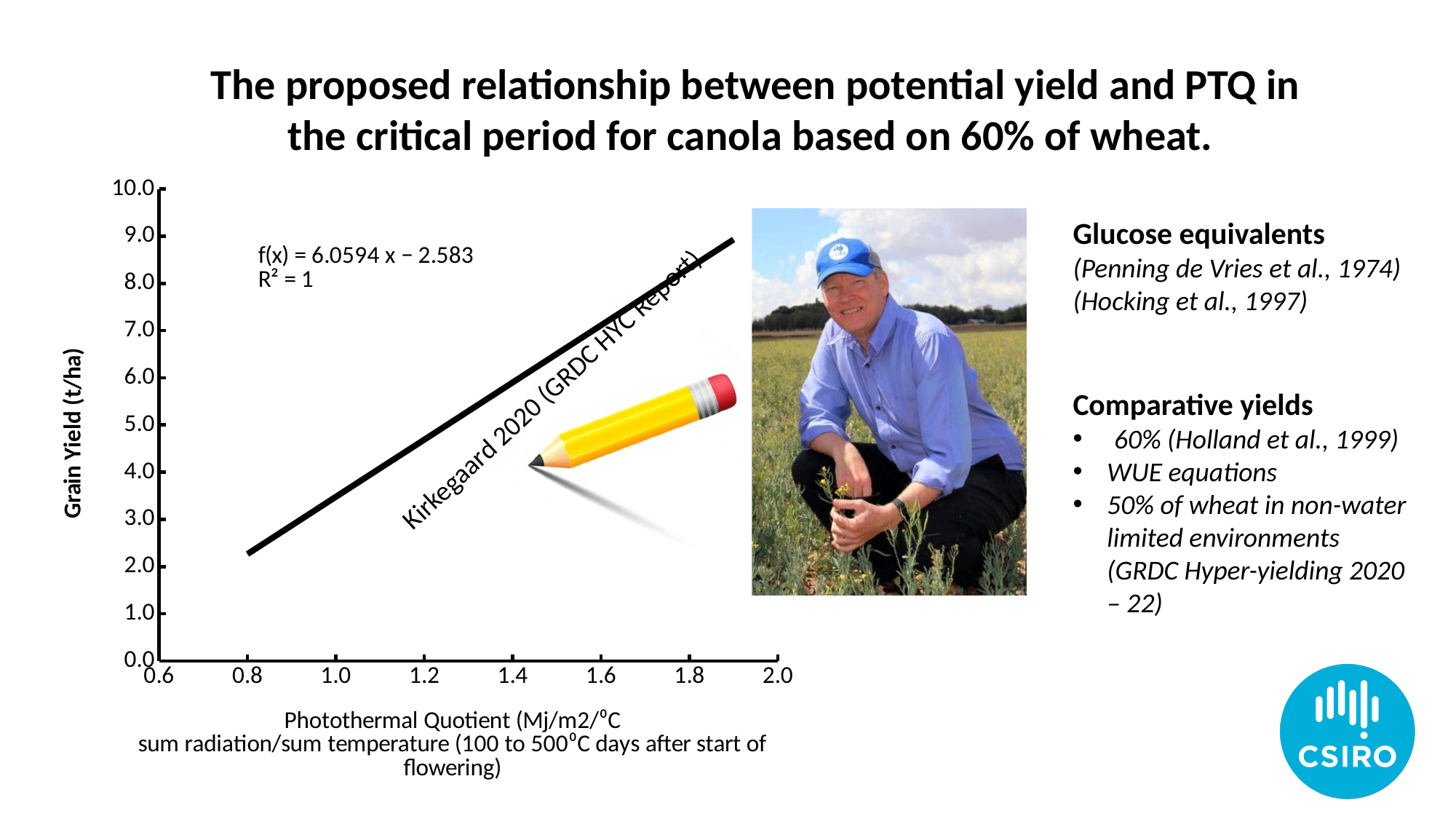
Is the grain yield at a photothermal quotient of 1.4 greater or less than 7.0 t/ha? less Is the grain yield at a photothermal quotient of 1.6 greater or less than 6.0 t/ha? greater What is the fitted equation printed on the chart? f(x) = 6.0594 x − 2.583 What kind of chart is shown on the slide? line chart Which has the higher grain yield: a photothermal quotient of 1.0 or 1.6? 1.6 Is the grain yield at a photothermal quotient of 1.8 greater or less than 7.0 t/ha? greater What R² value is printed on the chart? R² = 1 Does grain yield rise or fall as the photothermal quotient increases along the x axis? rise